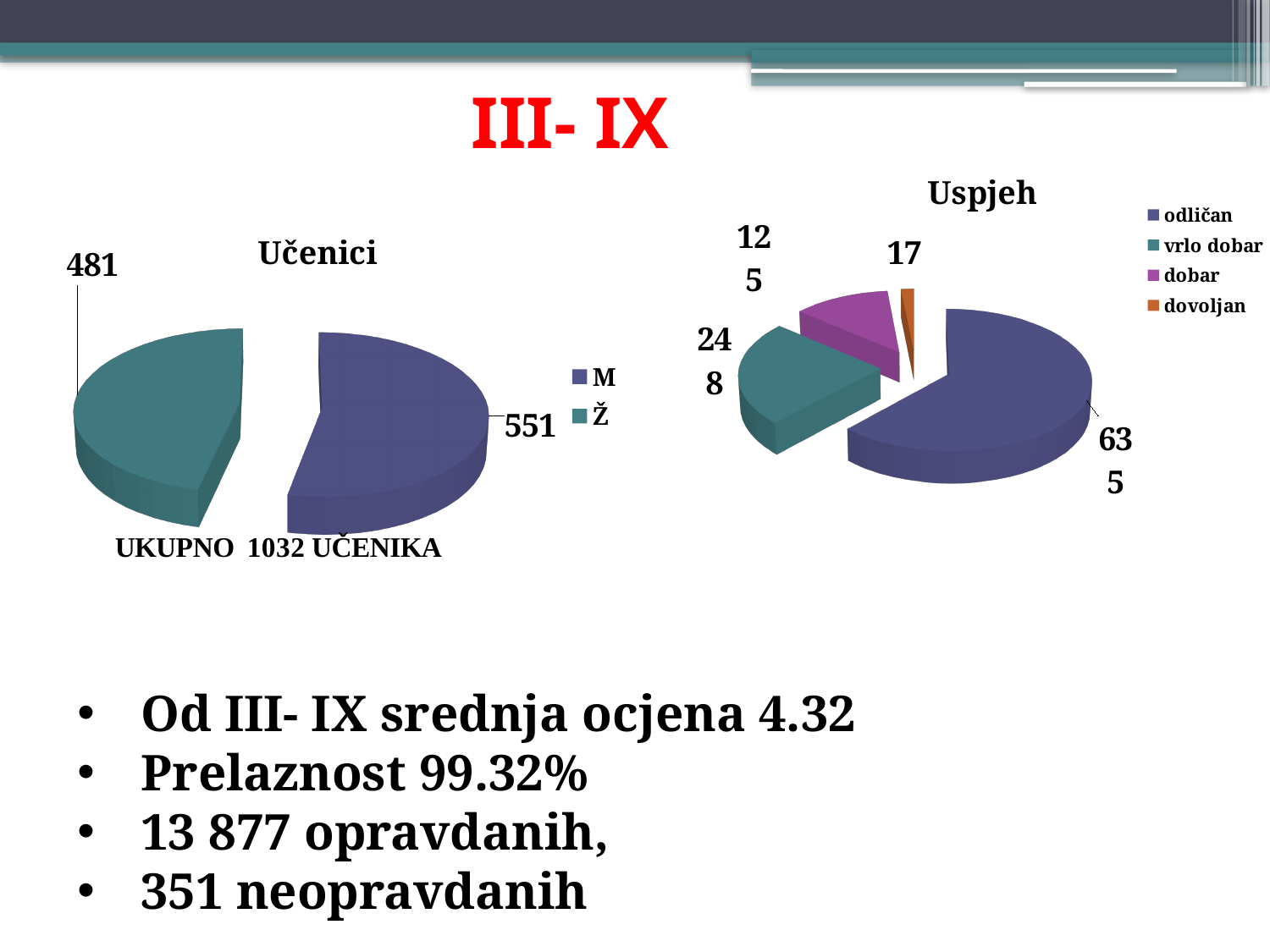
In the 'Uspjeh' pie chart, which category has the smallest slice? dovoljan In the 'Uspjeh' pie chart, what is the value for odličan? 635 How many categories does the legend of the 'Uspjeh' chart list? 4 In the 'Učenici' pie chart, what is the value for Ž? 481 What total number of students is stated below the 'Učenici' chart? 1032 What kind of chart is the 'Učenici' chart? Pie chart In the 'Uspjeh' pie chart, what is the value for dovoljan? 17 In the 'Učenici' pie chart, which is larger, M or Ž? M In the 'Uspjeh' pie chart, which category has the largest slice? odličan In the 'Učenici' pie chart, what is the value for M? 551 How many entries does the legend of the 'Učenici' chart list? 2 In the 'Učenici' pie chart, what is the difference between the values for M and Ž? 70